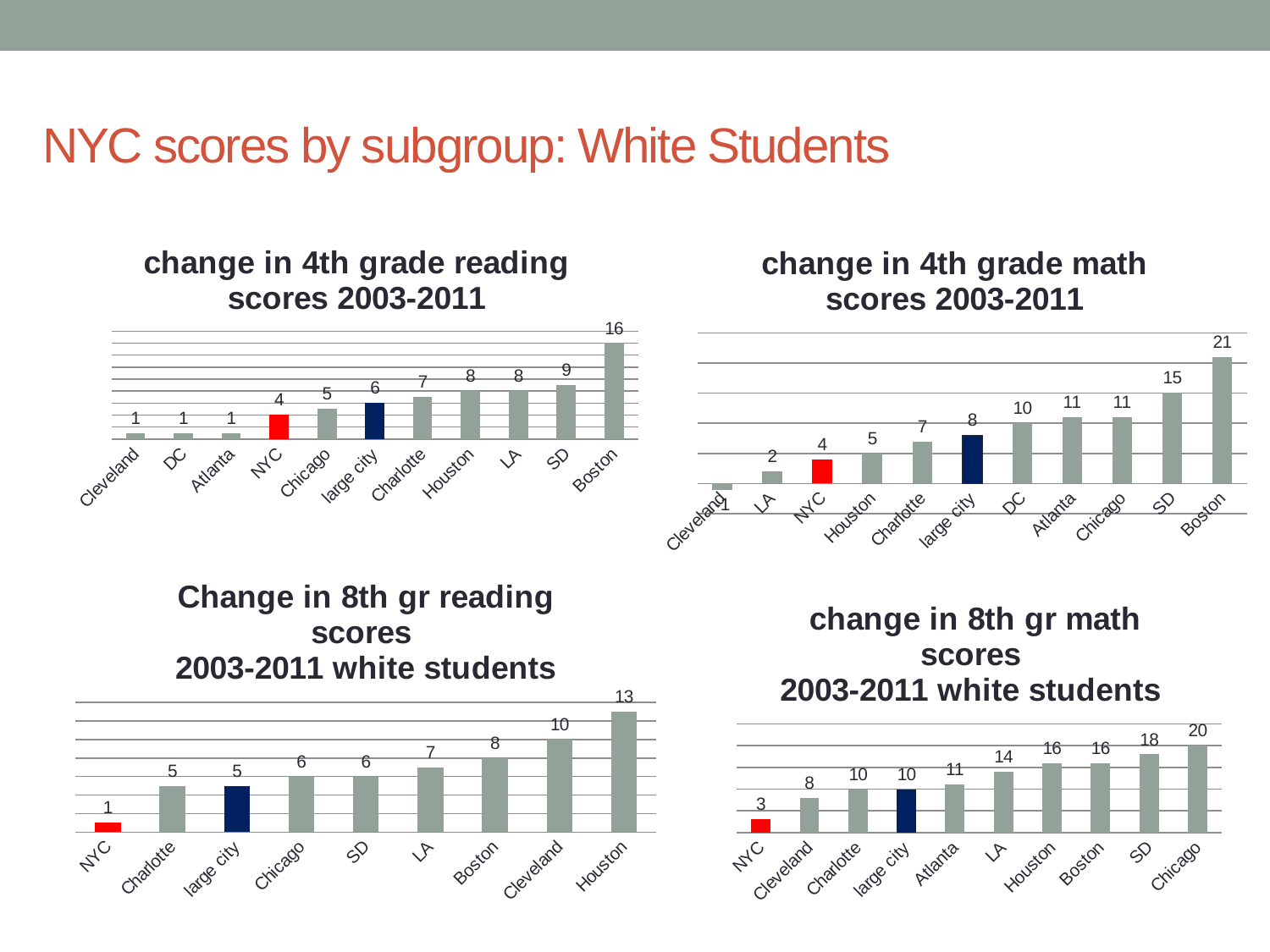
In the 'change in 8th gr math scores 2003-2011 white students' chart, what is the value for SD? 18 In the 'Change in 8th gr reading scores 2003-2011 white students' chart, how many cities are plotted? 9 In the 'change in 4th grade reading scores 2003-2011' chart, what is the difference between Boston and NYC? 12 In the 'change in 4th grade math scores 2003-2011' chart, which city has the lowest value? Cleveland In the 'change in 4th grade reading scores 2003-2011' chart, which city has the highest value? Boston In the 'change in 8th gr math scores 2003-2011 white students' chart, what is the difference between Chicago and NYC? 17 In the 'Change in 8th gr reading scores 2003-2011 white students' chart, what is the value for Houston? 13 In the 'change in 4th grade reading scores 2003-2011' chart, what is the value for NYC? 4 In the 'change in 4th grade math scores 2003-2011' chart, how many cities are plotted? 11 In the 'change in 4th grade math scores 2003-2011' chart, what is the value for large city? 8 What type of chart is the 'change in 8th gr math scores 2003-2011 white students' chart? Bar chart In the 'Change in 8th gr reading scores 2003-2011 white students' chart, which is larger, Cleveland or Boston? Cleveland